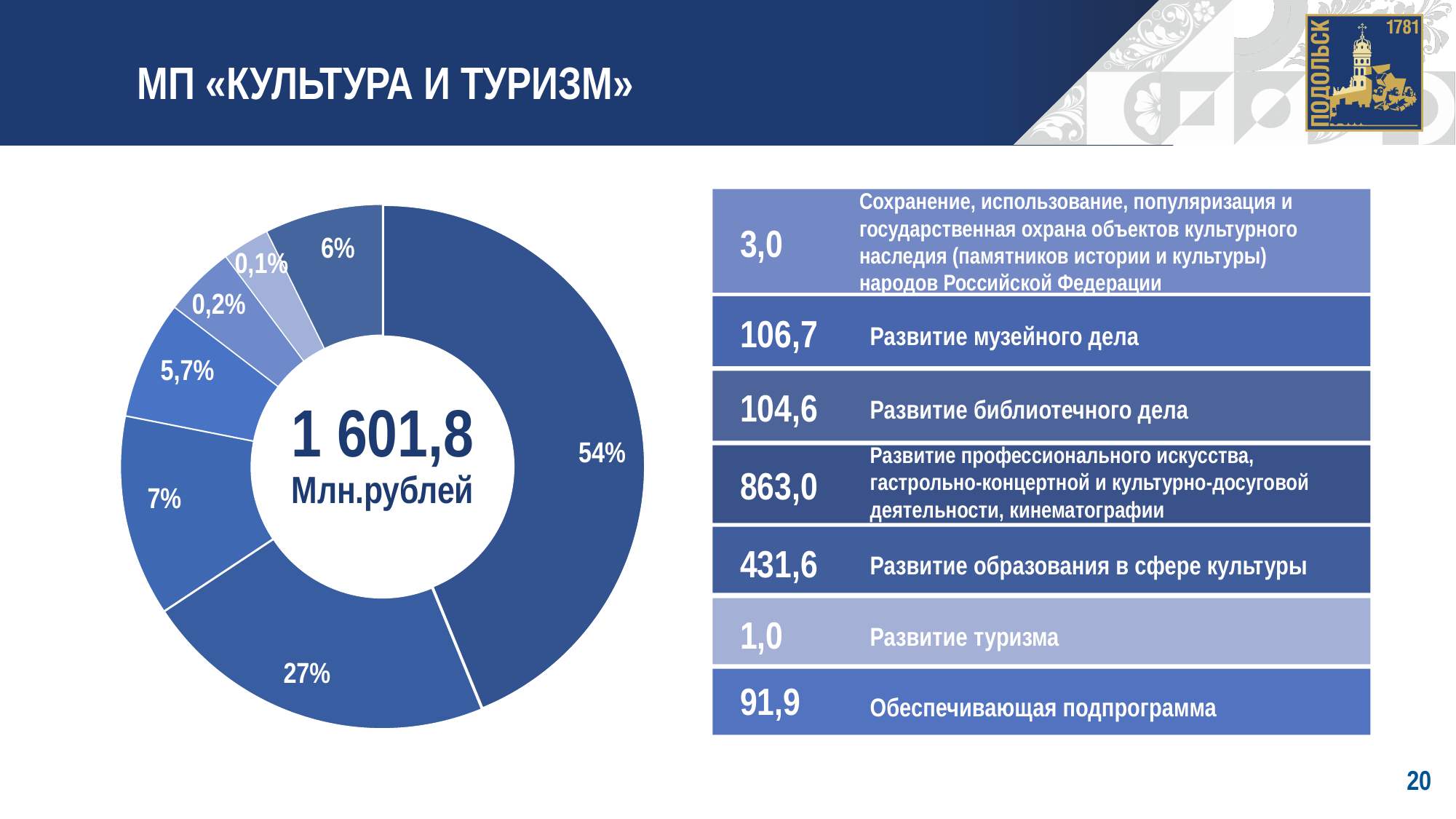
What is the value listed for «Развитие туризма»? 1,0 What is the difference between the values for «Развитие профессионального искусства, гастрольно-концертной и культурно-досуговой деятельности, кинематографии» (863,0) and «Развитие образования в сфере культуры» (431,6)? 431,4 Which subprogramme has the largest value in the list: «Развитие профессионального искусства, гастрольно-концертной и культурно-досуговой деятельности, кинематографии» or «Обеспечивающая подпрограмма»? Развитие профессионального искусства, гастрольно-концертной и культурно-досуговой деятельности, кинематографии What is the smallest percentage labelled on the donut chart? 0,1% What is the largest percentage labelled on the donut chart? 54% What unit is written in the centre of the donut chart? Млн.рублей What kind of chart is shown on the left of the slide? pie (donut) chart How many slices does the donut chart have? 7 What is the value listed for «Развитие музейного дела»? 106,7 What is the total shown in the centre of the donut chart? 1 601,8 Which is larger: the value for «Развитие музейного дела» or for «Развитие библиотечного дела»? Развитие музейного дела What is the value listed for «Развитие образования в сфере культуры»? 431,6